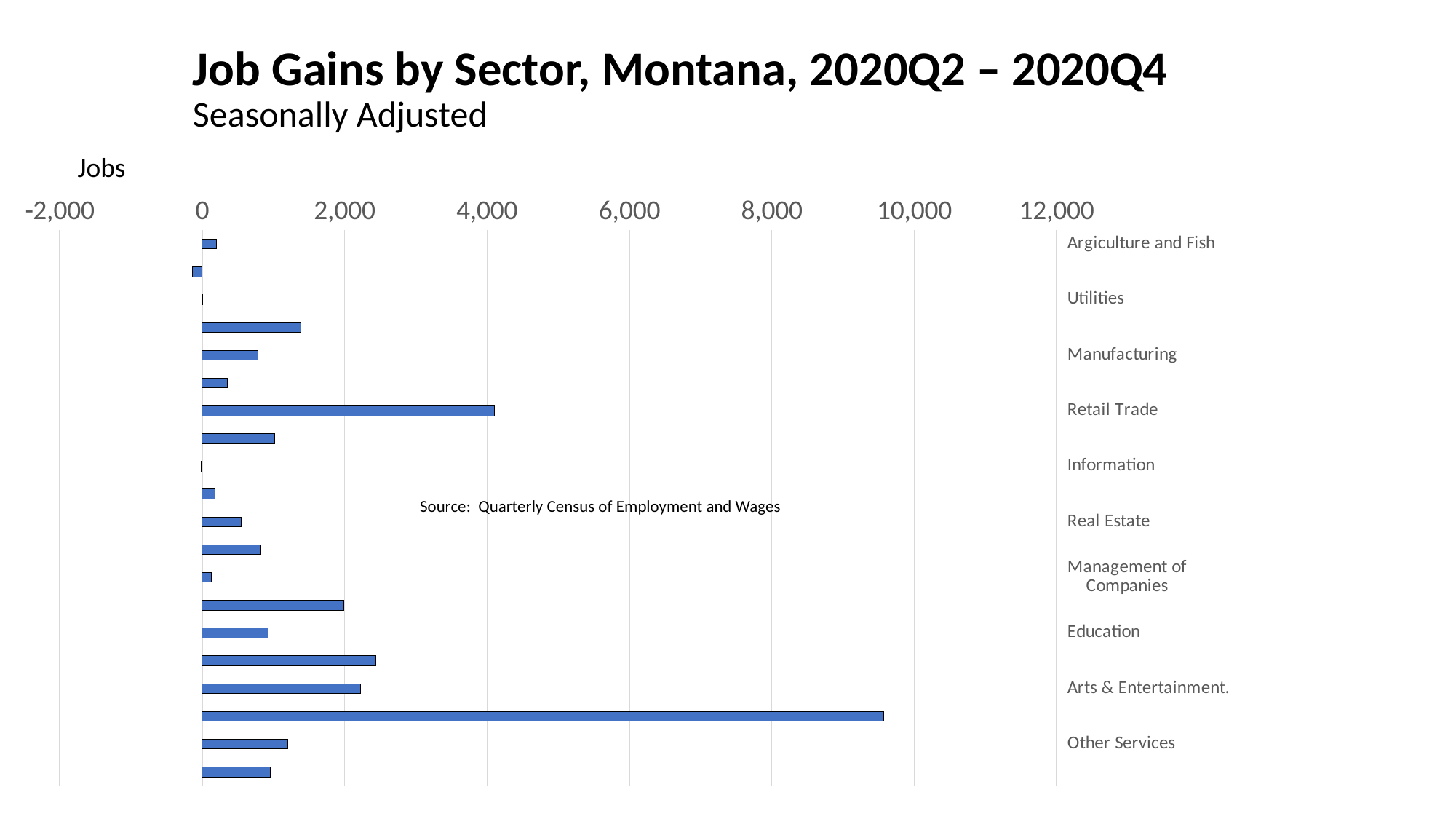
Which has the larger value, Retail Trade or Manufacturing? Retail Trade Is the value for Manufacturing greater or less than 2,000? less Is the value for Retail Trade greater or less than 2,000? greater Which has the larger value, Arts & Entertainment or Education? Arts & Entertainment Is the value for Other Services greater or less than 2,000? less How many bars are plotted in the chart? 20 Among the labeled sectors, which has the largest bar? Retail Trade What is the title of the chart? Job Gains by Sector, Montana, 2020Q2 – 2020Q4 What is the label on the value axis of the chart? Jobs What kind of chart is shown on the slide? bar chart